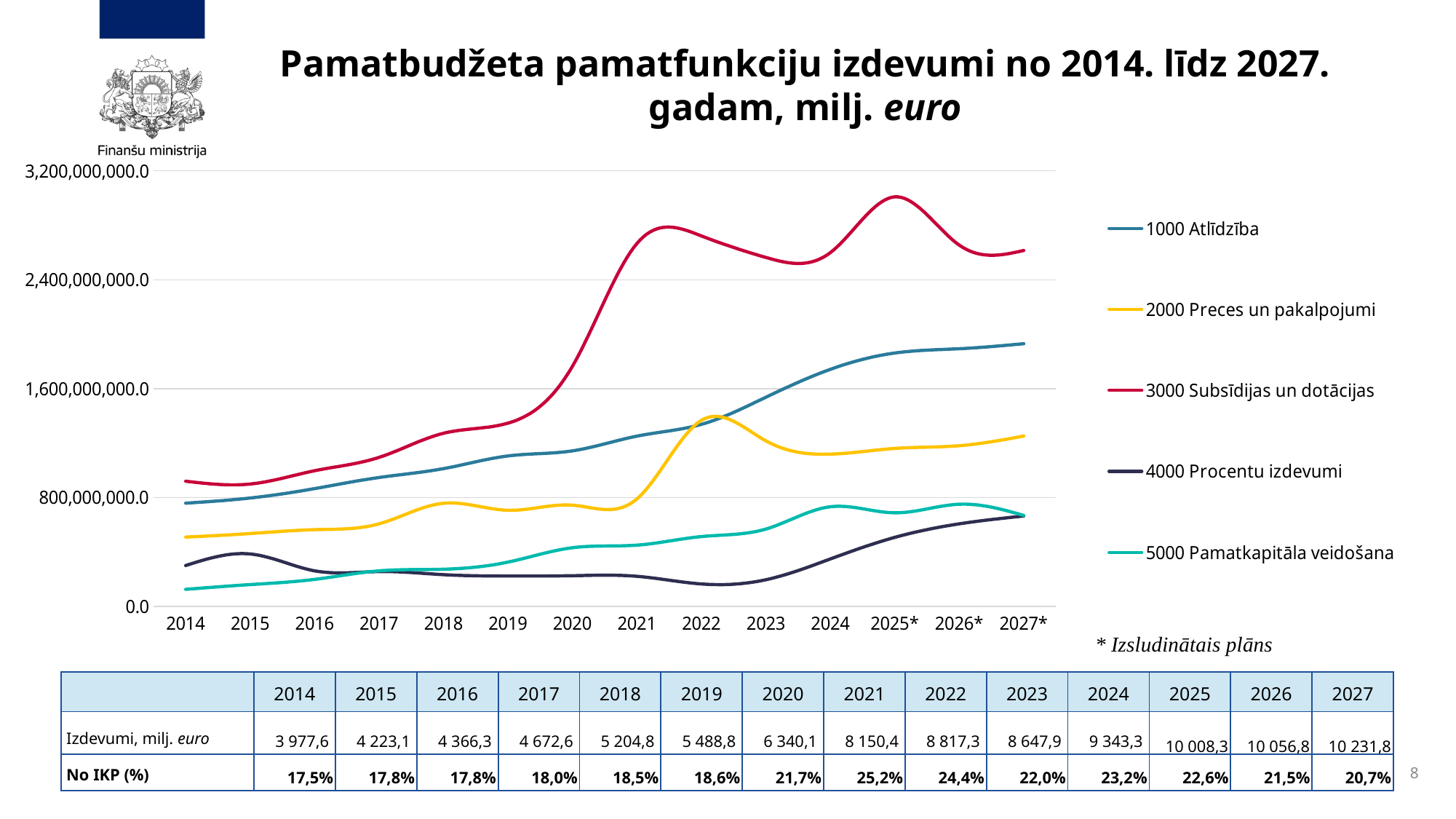
In 2022, which is larger: 2000 Preces un pakalpojumi or 4000 Procentu izdevumi? 2000 Preces un pakalpojumi Is the value for 2000 Preces un pakalpojumi in 2014 greater or less than 800,000,000.0? less Which series has the highest value in 2027*? 3000 Subsīdijas un dotācijas Which series has the lowest value in 2014? 5000 Pamatkapitāla veidošana In which year does the 3000 Subsīdijas un dotācijas line reach its peak? 2025* Is the value for 3000 Subsīdijas un dotācijas in 2025* greater or less than 2,400,000,000.0? greater What colour is the line for 3000 Subsīdijas un dotācijas? red Is the value for 1000 Atlīdzība in 2027* greater or less than 1,600,000,000.0? greater Does the 1000 Atlīdzība line rise or fall from 2014 to 2027*? rises How many series does the chart's legend list? 5 What kind of chart is shown on the slide? line chart How many years are shown along the x axis of the chart? 14